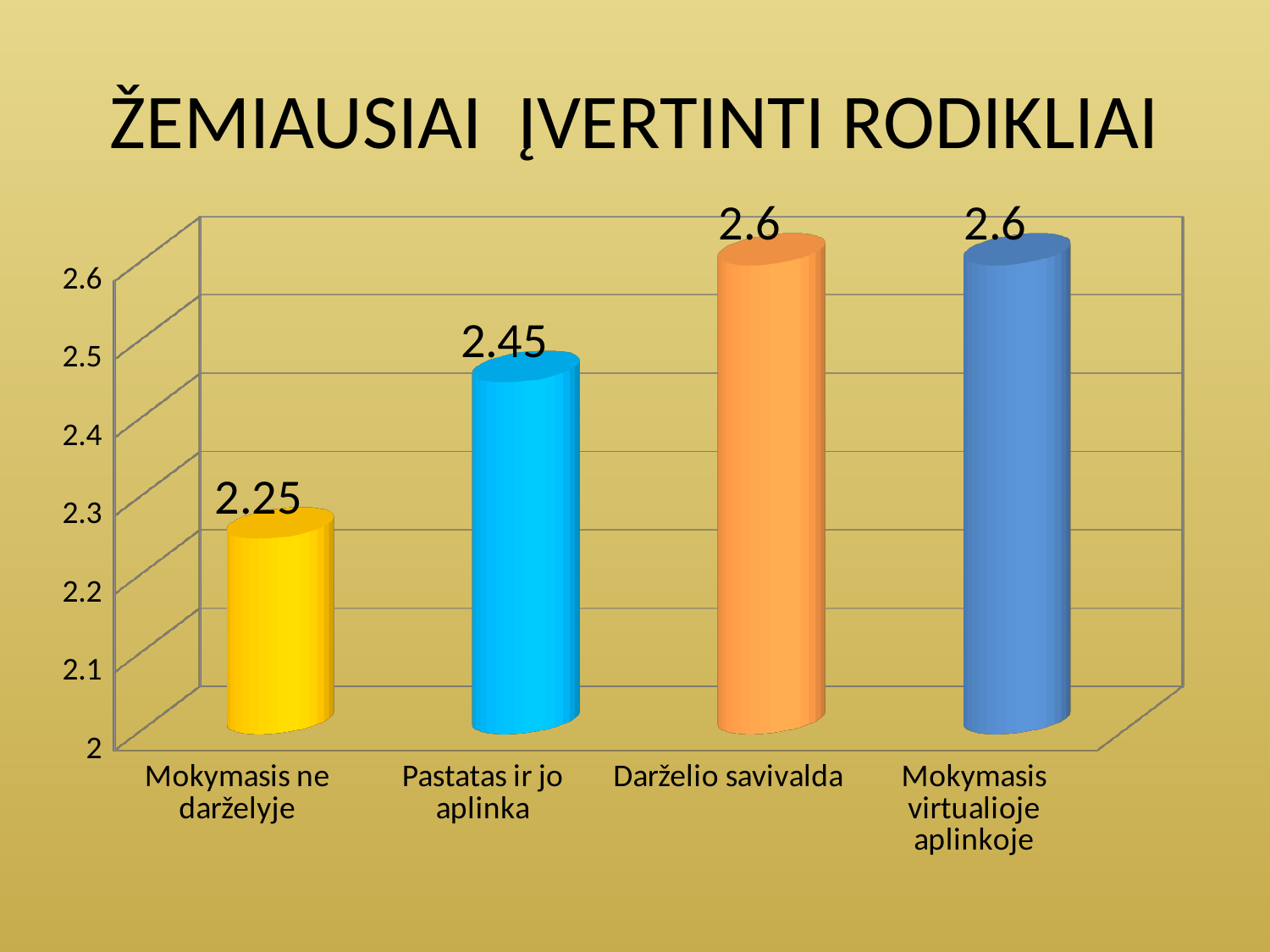
What is the difference between the values for Pastatas ir jo aplinka and Mokymasis ne darželyje? 0.2 What is the value for Mokymasis ne darželyje? 2.25 What kind of chart is shown on the slide? bar chart Which category has the lowest value? Mokymasis ne darželyje What is the value for Mokymasis virtualioje aplinkoje? 2.6 What is the difference between the values for Darželio savivalda and Pastatas ir jo aplinka? 0.15 What is the value for Pastatas ir jo aplinka? 2.45 What is the value for Darželio savivalda? 2.6 How many categories are shown on the chart? 4 Is the value for Mokymasis ne darželyje greater or less than 2.3? less What is the title of the slide? ŽEMIAUSIAI ĮVERTINTI RODIKLIAI Which is larger, the value for Pastatas ir jo aplinka or the value for Mokymasis ne darželyje? Pastatas ir jo aplinka